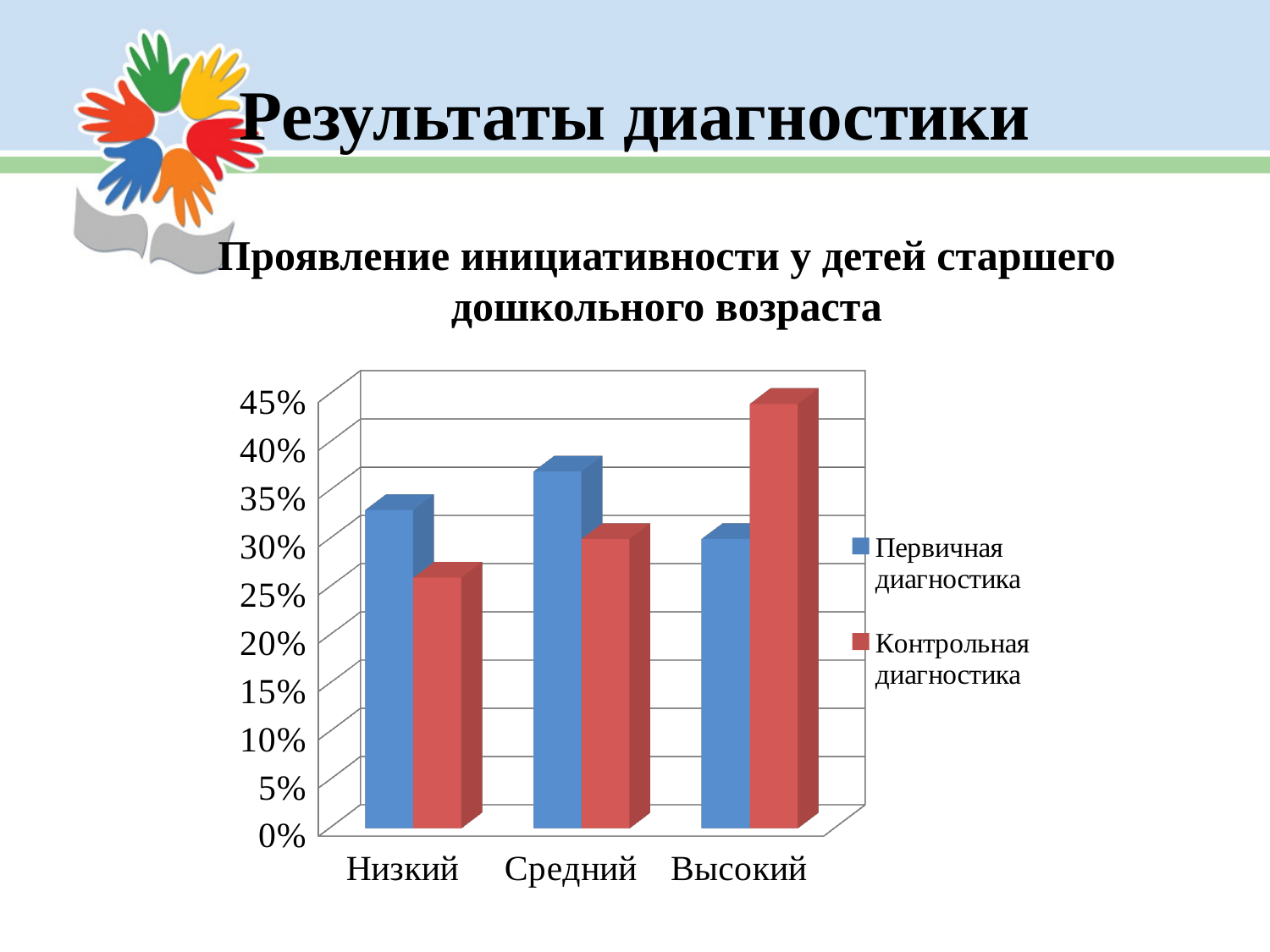
For which category is the Контрольная диагностика value lowest? Низкий For the Низкий category, which series has the larger value: Первичная диагностика or Контрольная диагностика? Первичная диагностика For the Высокий category, which series has the larger value: Первичная диагностика or Контрольная диагностика? Контрольная диагностика How many series does the chart's legend list? 2 For which category is the Первичная диагностика value highest? Средний What kind of chart is shown on the slide? Bar chart Is the Контрольная диагностика value for Высокий greater or less than 40%? greater How many categories are shown on the x axis of the chart? 3 What is the title of the chart? Проявление инициативности у детей старшего дошкольного возраста For which category is the Контрольная диагностика value highest? Высокий Is the Контрольная диагностика value for Низкий greater or less than 30%? less Which series is shown in red in the chart? Контрольная диагностика